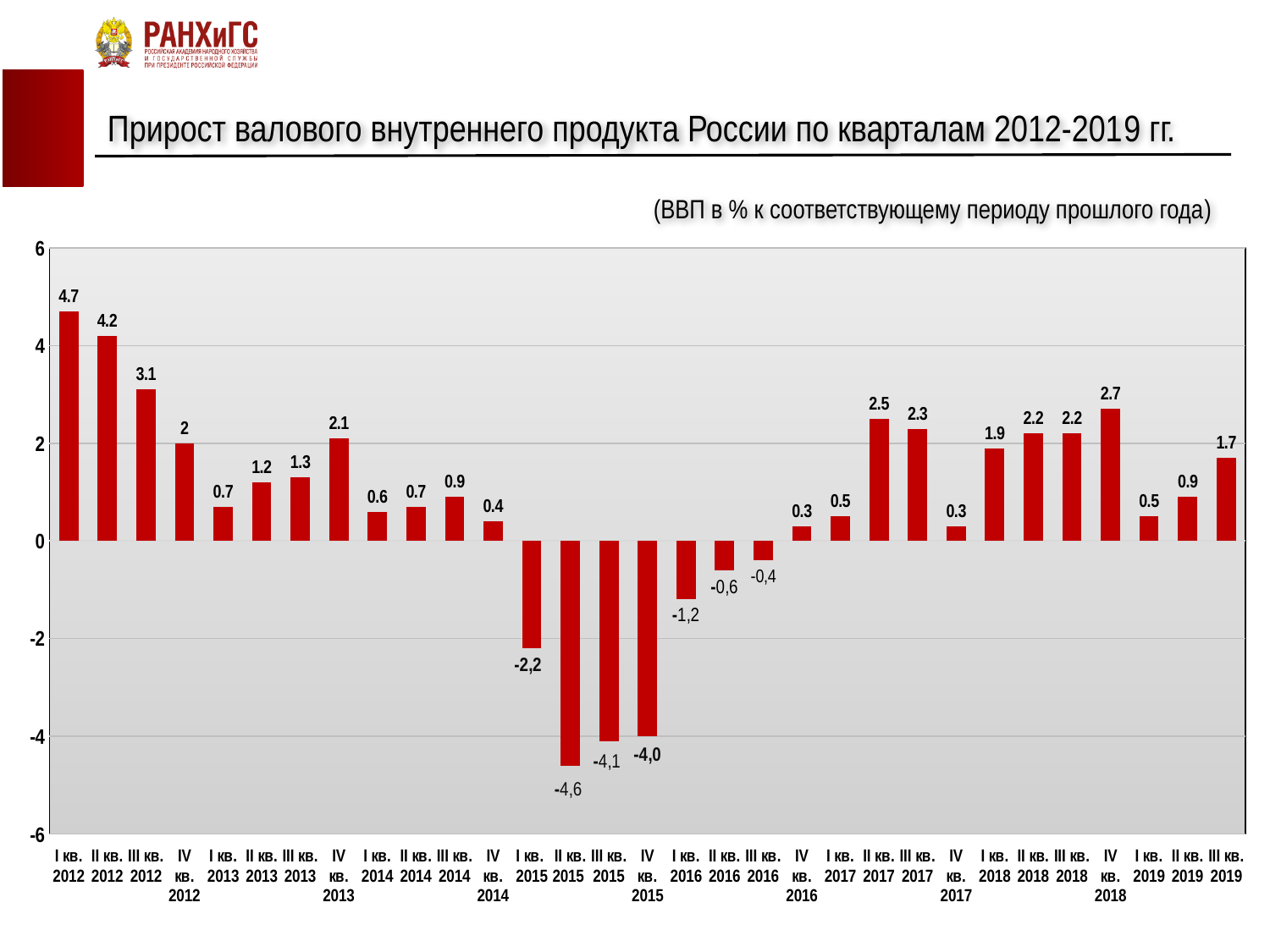
What kind of chart is shown on the slide? bar chart What is the GDP growth value for I кв. 2012? 4.7 Is the value for I кв. 2015 greater or less than -2? less What is the difference between the values for I кв. 2012 and II кв. 2012? 0.5 What is the value shown for IV кв. 2018? 2.7 Do the values rise or fall from I кв. 2012 to IV кв. 2012? fall How many quarterly bars are plotted on the chart? 31 What is the value shown for III кв. 2019? 1.7 Which quarter has the lowest GDP growth value? II кв. 2015 Which is larger, the value for II кв. 2017 or the value for III кв. 2017? II кв. 2017 Which quarter has the highest GDP growth value? I кв. 2012 What is the value shown for II кв. 2015? -4,6